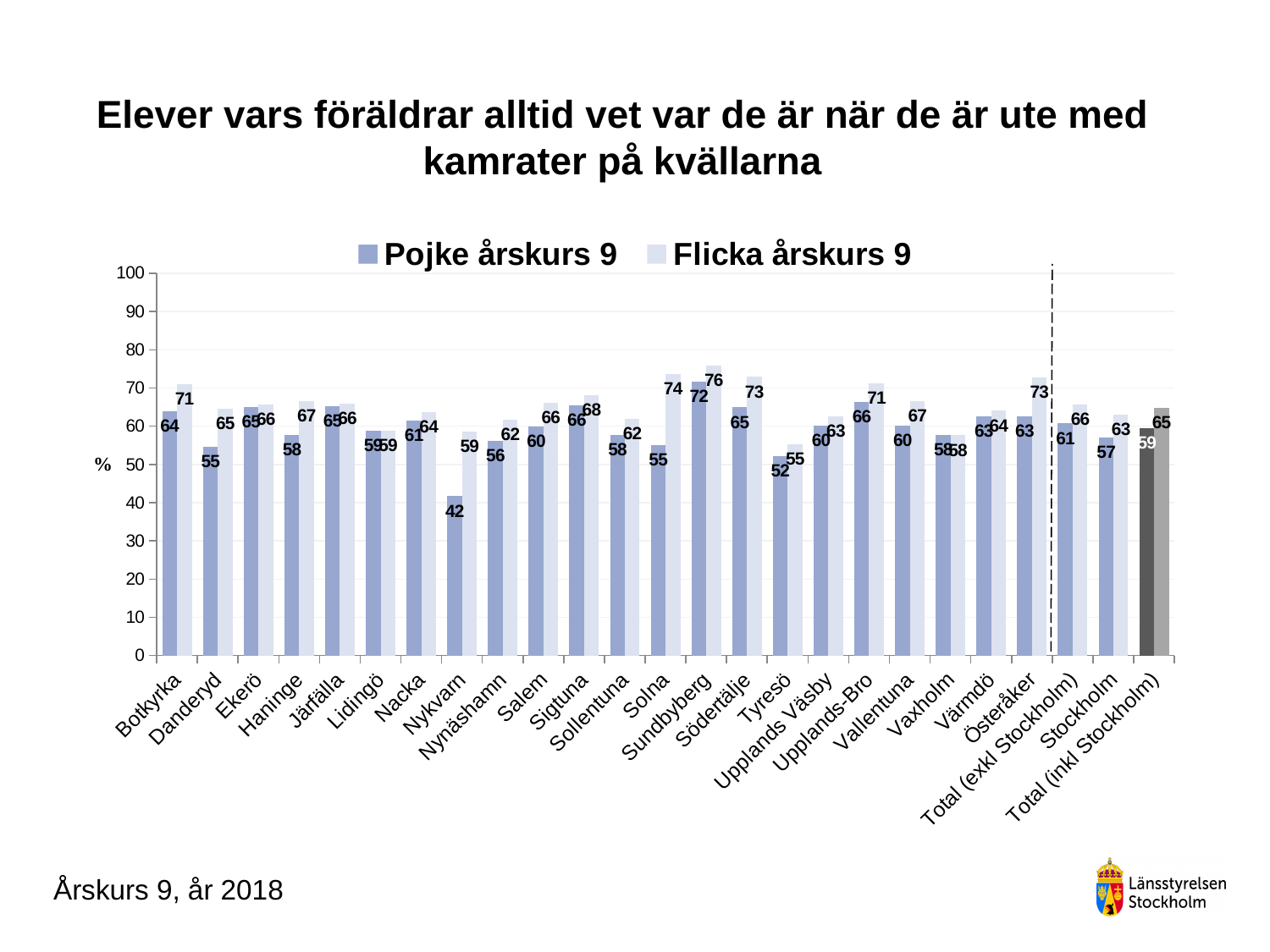
Which category has the lowest value for Pojke årskurs 9? Nykvarn What is the unit shown on the y axis label? % Is the value for Pojke årskurs 9 in Sundbyberg greater or less than 70? greater What is the value for Pojke årskurs 9 in Nykvarn? 42 What kind of chart is shown on the slide? Bar chart Which category has the highest value for Flicka årskurs 9? Sundbyberg How many categories are shown on the x axis? 25 What is the value for Flicka årskurs 9 in Solna? 74 What is the difference between the Flicka årskurs 9 and Pojke årskurs 9 values in Solna? 19 How many series does the legend list? 2 What is the value for Pojke årskurs 9 for Total (inkl Stockholm)? 59 Which is larger in Österåker: the Pojke årskurs 9 value or the Flicka årskurs 9 value? Flicka årskurs 9